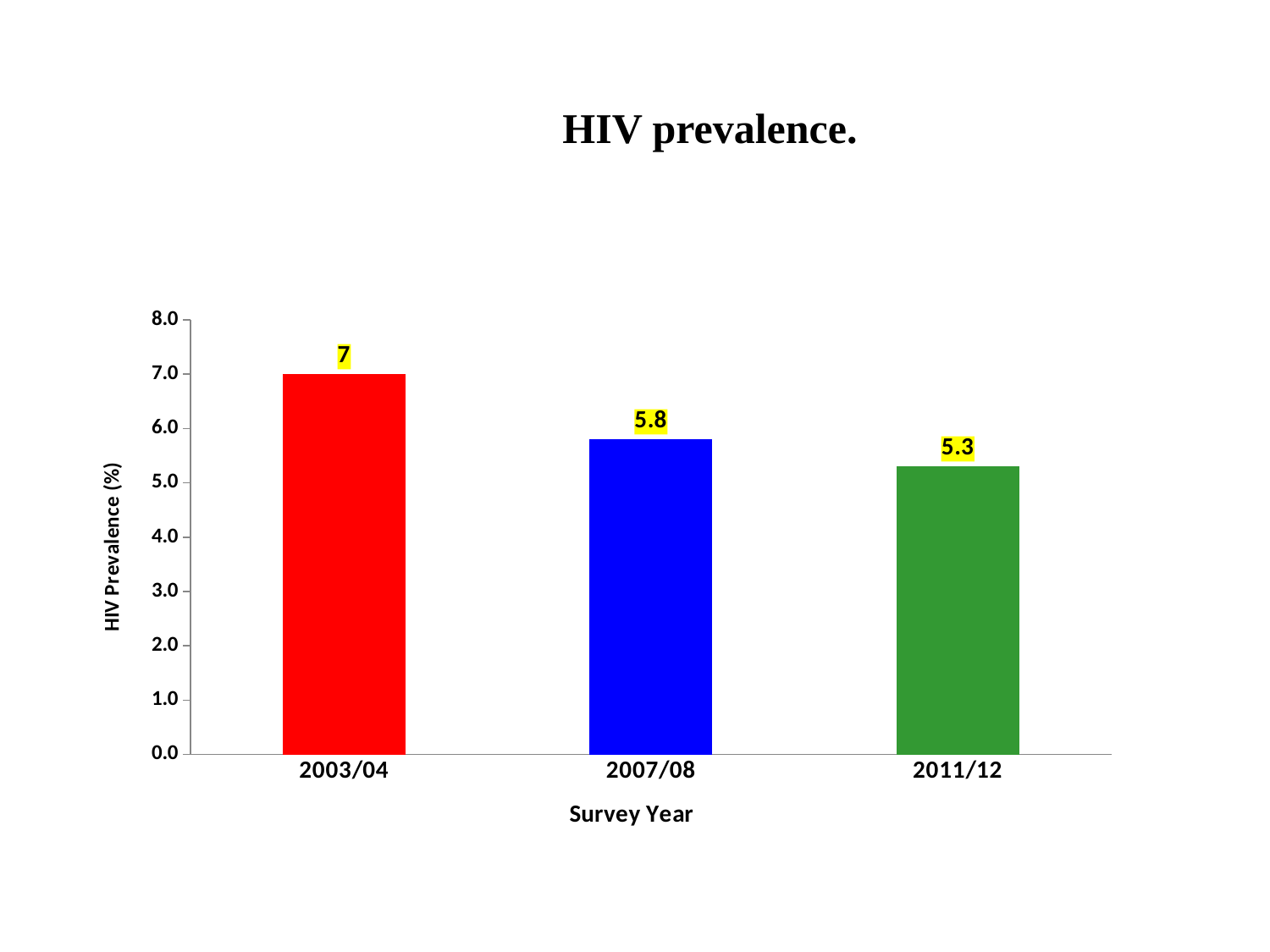
Which survey year has the highest HIV prevalence? 2003/04 What is the HIV prevalence value for 2003/04? 7 How many survey years are shown on the chart? 3 Which survey year has the lowest HIV prevalence? 2011/12 Is the HIV prevalence for 2007/08 greater or less than 6.0? less What kind of chart is shown on the slide? bar chart What is the HIV prevalence value for 2007/08? 5.8 Does HIV prevalence rise or fall across the survey years from 2003/04 to 2011/12? fall What is the difference in HIV prevalence between 2003/04 and 2011/12? 1.7 What is the difference in HIV prevalence between 2007/08 and 2011/12? 0.5 What is the HIV prevalence value for 2011/12? 5.3 Which has a higher HIV prevalence, 2007/08 or 2011/12? 2007/08